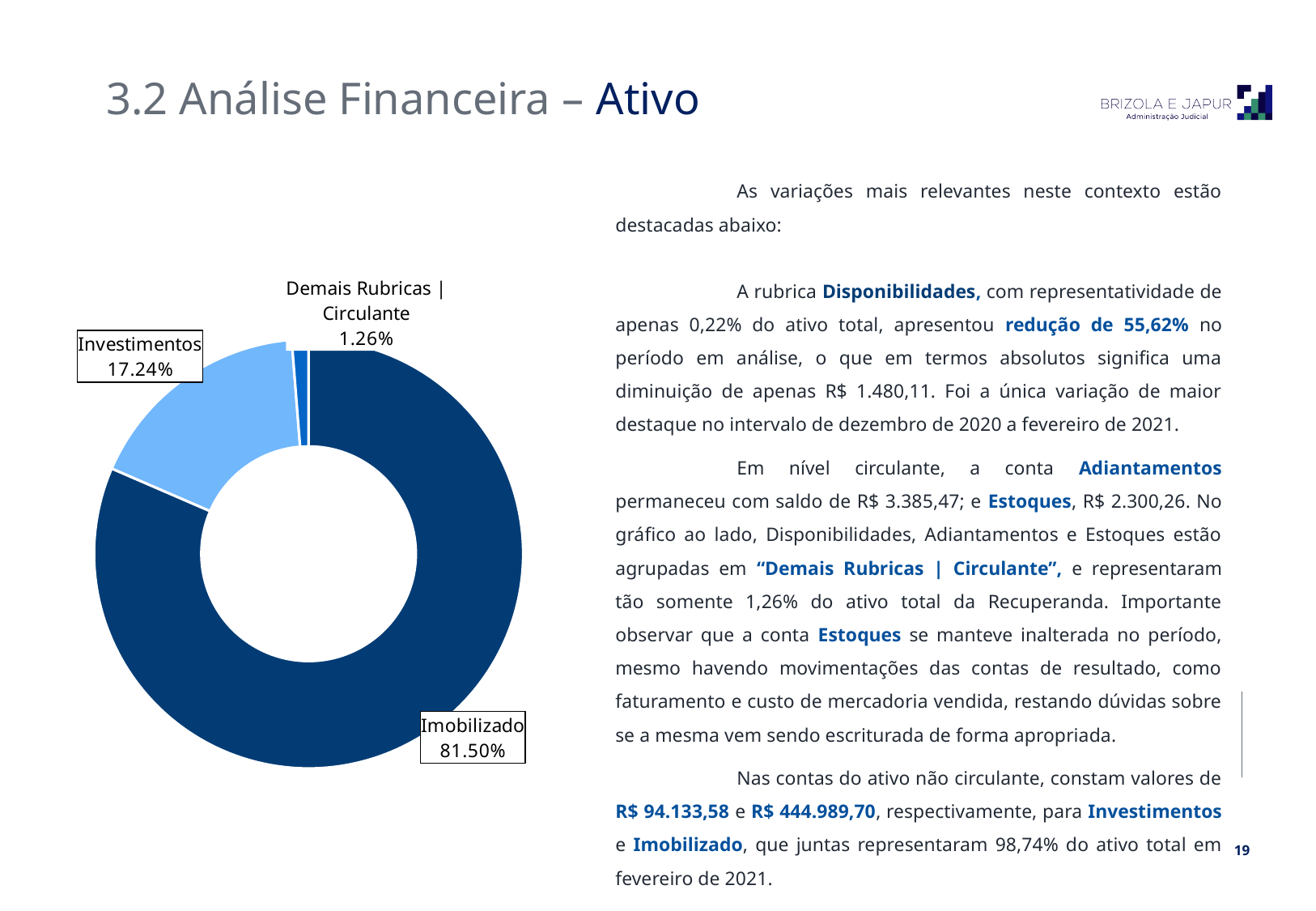
What share of the pie does Investimentos represent? 17.24% Which category has the smallest slice of the pie? Demais Rubricas | Circulante What is the combined share of Imobilizado and Investimentos? 98.74% What share of the pie does Imobilizado represent? 81.50% What share of the pie does Demais Rubricas | Circulante represent? 1.26% What is the difference in percentage points between the Investimentos and Demais Rubricas | Circulante slices? 15.98 What colour is the Investimentos slice? Light blue Which category has the largest slice of the pie? Imobilizado What kind of chart is shown on the slide? Pie chart (doughnut) How many categories are shown in the pie chart? 3 What is the difference in percentage points between the Imobilizado and Investimentos slices? 64.26 Which slice is larger, Investimentos or Demais Rubricas | Circulante? Investimentos